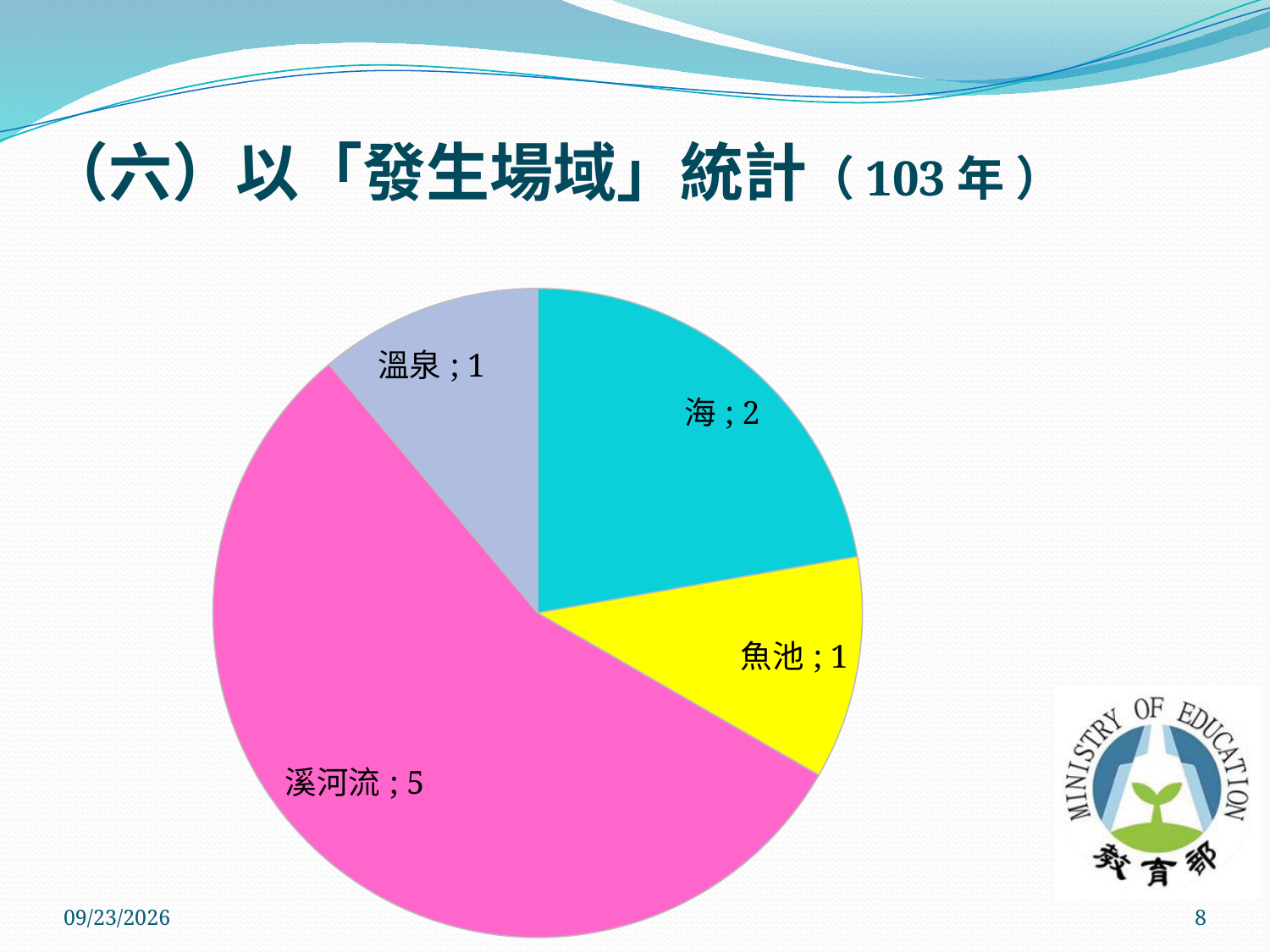
What is the value for 魚池 in the pie chart? 1 What is the value for 溪河流 in the pie chart? 5 Which category has the largest slice in the pie chart? 溪河流 What is the difference between the values for 溪河流 and 海? 3 What kind of chart is shown on the slide? pie chart Which two categories share the smallest value in the pie chart? 魚池 and 溫泉 What is the value for 溫泉 in the pie chart? 1 What is the title of the slide containing the pie chart? （六）以「發生場域」統計（103年） What is the total of all the slices in the pie chart? 9 Which is larger, the value for 海 or the value for 魚池? 海 How many slices does the pie chart have? 4 What is the value for 海 in the pie chart? 2